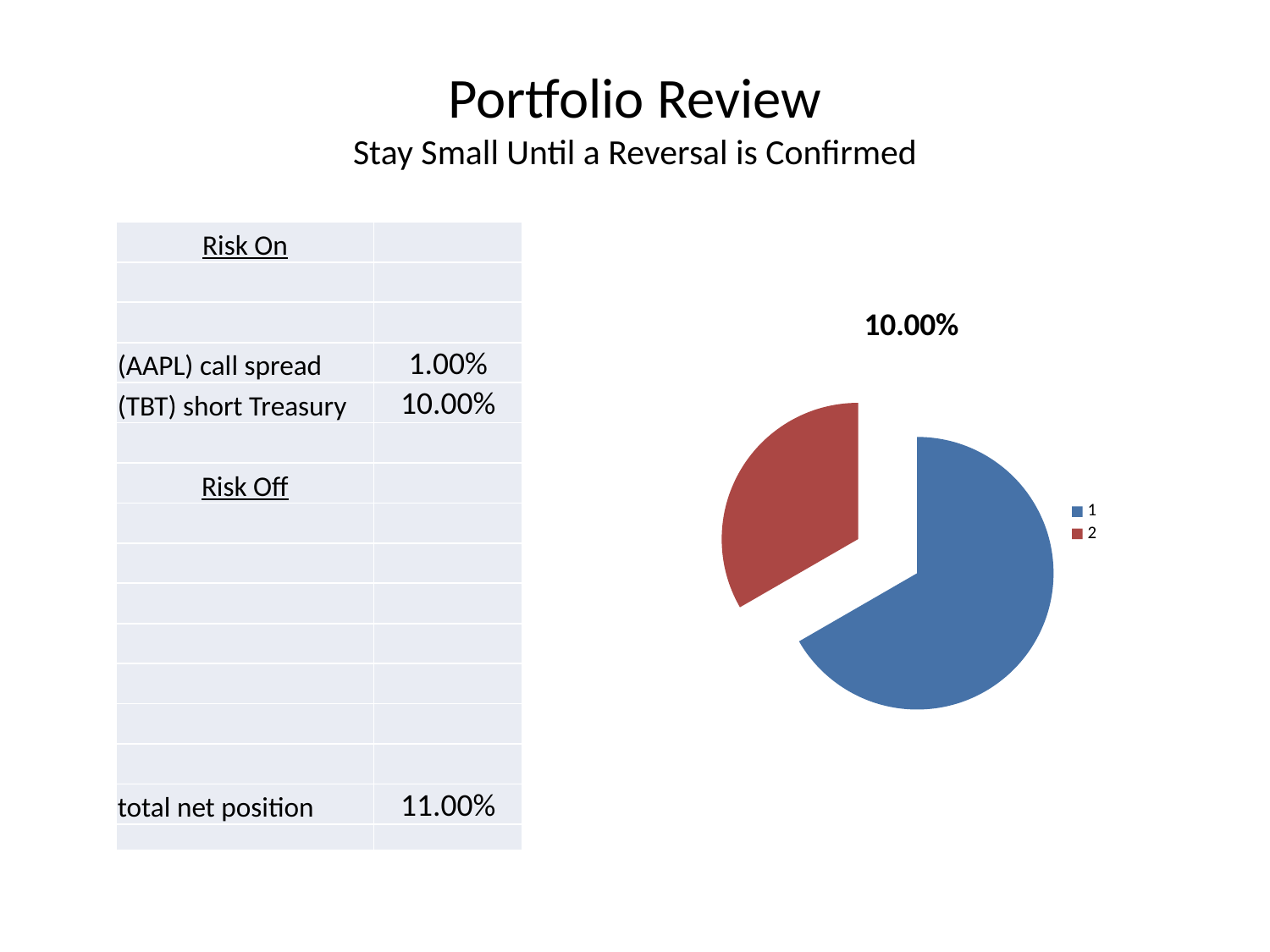
What is the title shown above the pie chart? 10.00% In the pie chart, which slice is larger, 1 or 2? 1 How many slices does the pie chart have? 2 What kind of chart is shown on the slide? pie chart Which slice of the pie chart is the smallest? 2 What colour is slice 2 in the pie chart? red How many entries does the pie chart's legend list? 2 Which slice of the pie chart is the largest? 1